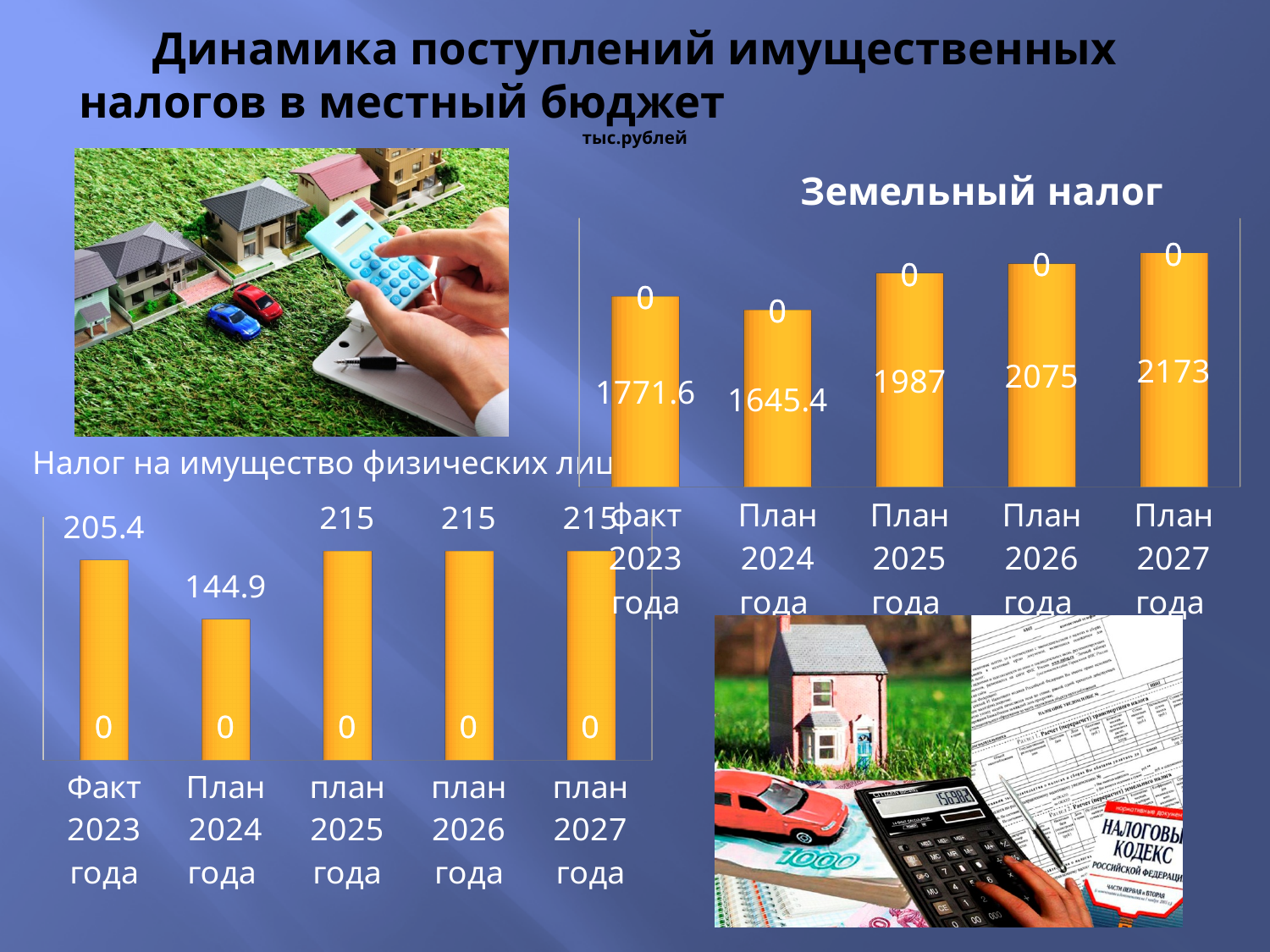
What type of chart is the 'Земельный налог' chart? Bar chart In the 'Налог на имущество физических лиц' chart, what is the value for План 2024 года? 144.9 In the 'Земельный налог' chart, what is the value for Факт 2023 года? 1771.6 In the 'Земельный налог' chart, which category has the lowest value? План 2024 года In the 'Налог на имущество физических лиц' chart, which category has the lowest value? План 2024 года How many categories are shown in the 'Налог на имущество физических лиц' chart? 5 In the 'Налог на имущество физических лиц' chart, what is the value for Факт 2023 года? 205.4 In the 'Земельный налог' chart, which is larger: the value for Факт 2023 года or План 2024 года? Факт 2023 года In the 'Земельный налог' chart, what is the difference between the values for План 2027 года and План 2026 года? 98 In the 'Земельный налог' chart, what is the value for План 2025 года? 1987 In the 'Налог на имущество физических лиц' chart, what is the difference between the values for Факт 2023 года and План 2024 года? 60.5 In the 'Земельный налог' chart, which category has the highest value? План 2027 года